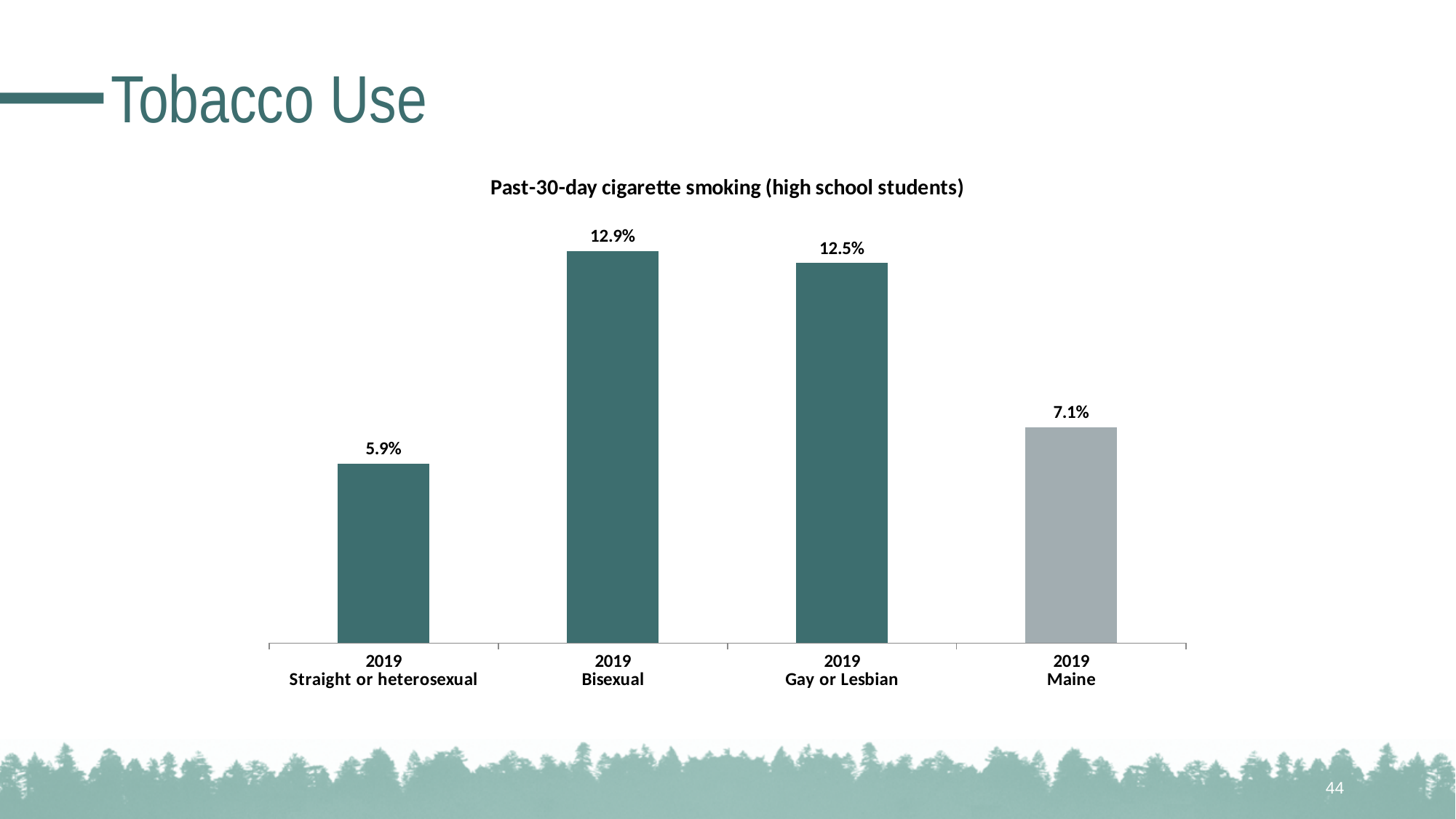
What is the difference in past-30-day cigarette smoking rate between Bisexual and Straight or heterosexual students? 7.0% What is the title of the chart? Past-30-day cigarette smoking (high school students) What is the past-30-day cigarette smoking rate for Straight or heterosexual high school students in 2019? 5.9% How many bars are shown in the chart? 4 Which is larger, the smoking rate for Maine overall or for Straight or heterosexual students? Maine What is the past-30-day cigarette smoking rate for Gay or Lesbian high school students in 2019? 12.5% Which group has the lowest past-30-day cigarette smoking rate? Straight or heterosexual Which group has the highest past-30-day cigarette smoking rate? Bisexual What type of chart is shown on the slide? Bar chart What is the past-30-day cigarette smoking rate for Bisexual high school students in 2019? 12.9% What is the past-30-day cigarette smoking rate for Maine overall in 2019? 7.1% What is the difference in past-30-day cigarette smoking rate between Gay or Lesbian students and Maine overall? 5.4%